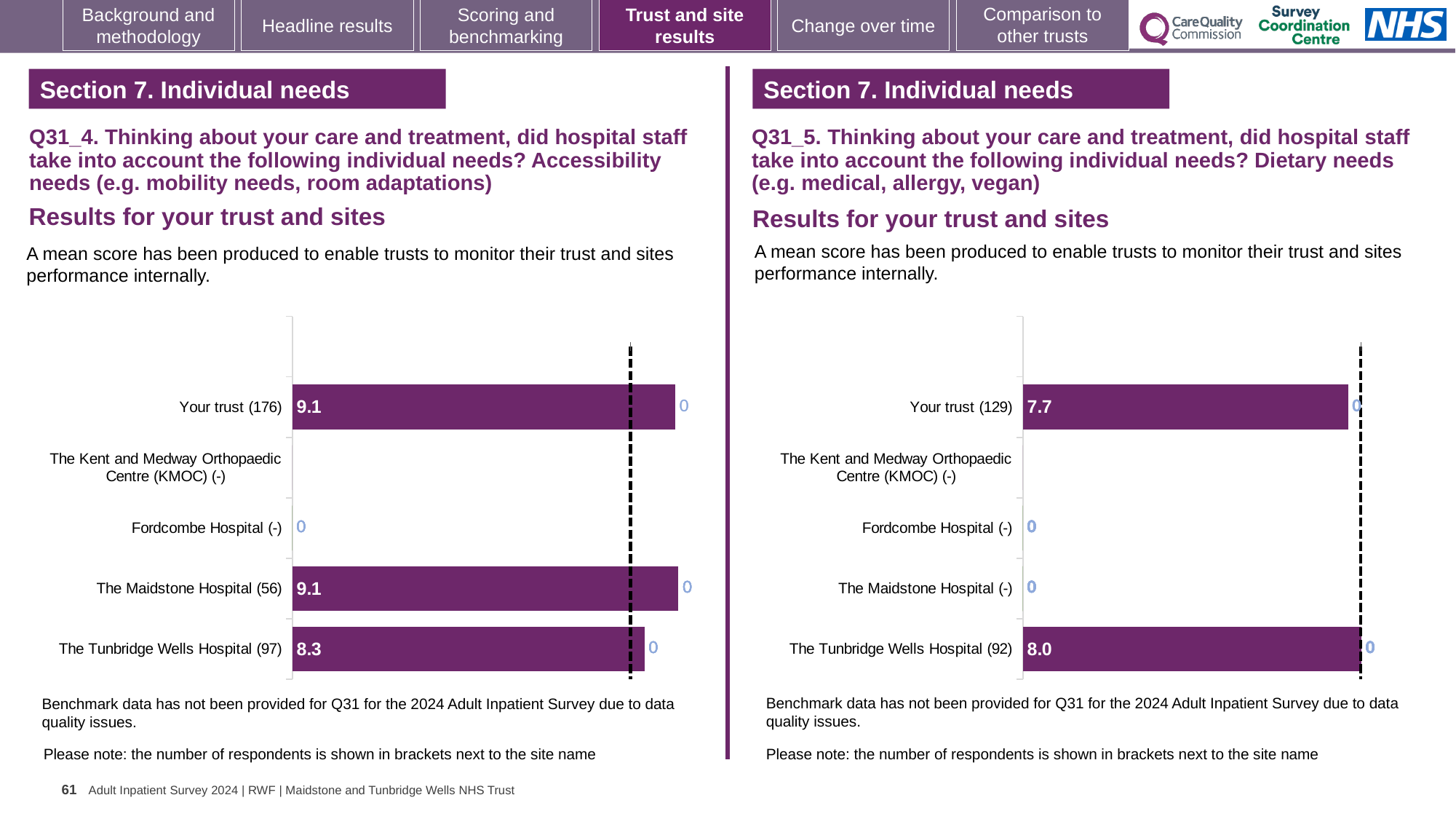
In the Q31_4 Accessibility needs chart, what is the mean score for The Maidstone Hospital (56)? 9.1 In the Q31_4 Accessibility needs chart, what is the difference between the scores for The Maidstone Hospital (56) and The Tunbridge Wells Hospital (97)? 0.8 In the Q31_5 Dietary needs chart, what is the mean score for The Tunbridge Wells Hospital (92)? 8.0 What type of chart is used for the Q31_5 Dietary needs results? Bar chart In the Q31_5 Dietary needs chart, which site has the highest mean score? The Tunbridge Wells Hospital (92) In the Q31_4 Accessibility needs chart, what is the mean score for The Tunbridge Wells Hospital (97)? 8.3 How many categories are listed on the y axis of the Q31_4 Accessibility needs chart? 5 In the Q31_4 Accessibility needs chart, what is the mean score for Your trust (176)? 9.1 In the Q31_5 Dietary needs chart, what is the mean score for Your trust (129)? 7.7 In the Q31_5 Dietary needs chart, what is the difference between the scores for The Tunbridge Wells Hospital (92) and Your trust (129)? 0.3 In the Q31_5 Dietary needs chart, which has the higher score: Your trust (129) or The Tunbridge Wells Hospital (92)? The Tunbridge Wells Hospital (92) In the Q31_4 Accessibility needs chart, how many respondents are shown for The Maidstone Hospital? 56